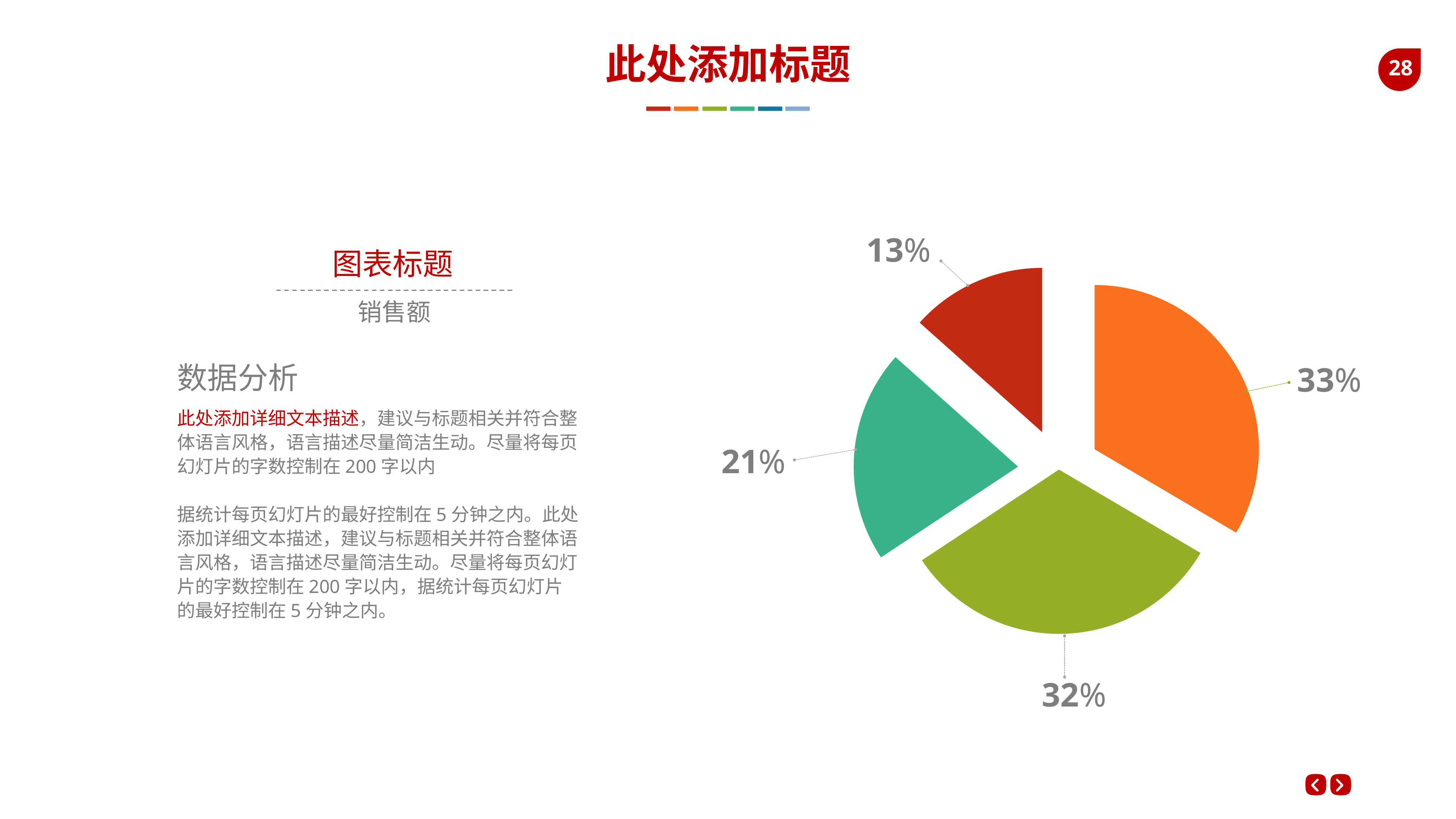
What percentage is shown for the teal slice of the pie chart? 21% What percentage is shown for the red slice of the pie chart? 13% Which slice of the pie chart has the largest share? the orange slice (33%) What kind of chart is shown on the slide? pie chart How many slices does the pie chart have? 4 What is the difference between the orange slice and the red slice in the pie chart? 20% What percentage is shown for the green slice of the pie chart? 32% Which slice of the pie chart has the smallest share? the red slice (13%) What is the title shown above the pie chart's description on the left? 图表标题 What is the difference between the green slice and the teal slice in the pie chart? 11% Which is larger in the pie chart, the teal slice or the red slice? the teal slice What percentage is shown for the orange slice of the pie chart? 33%